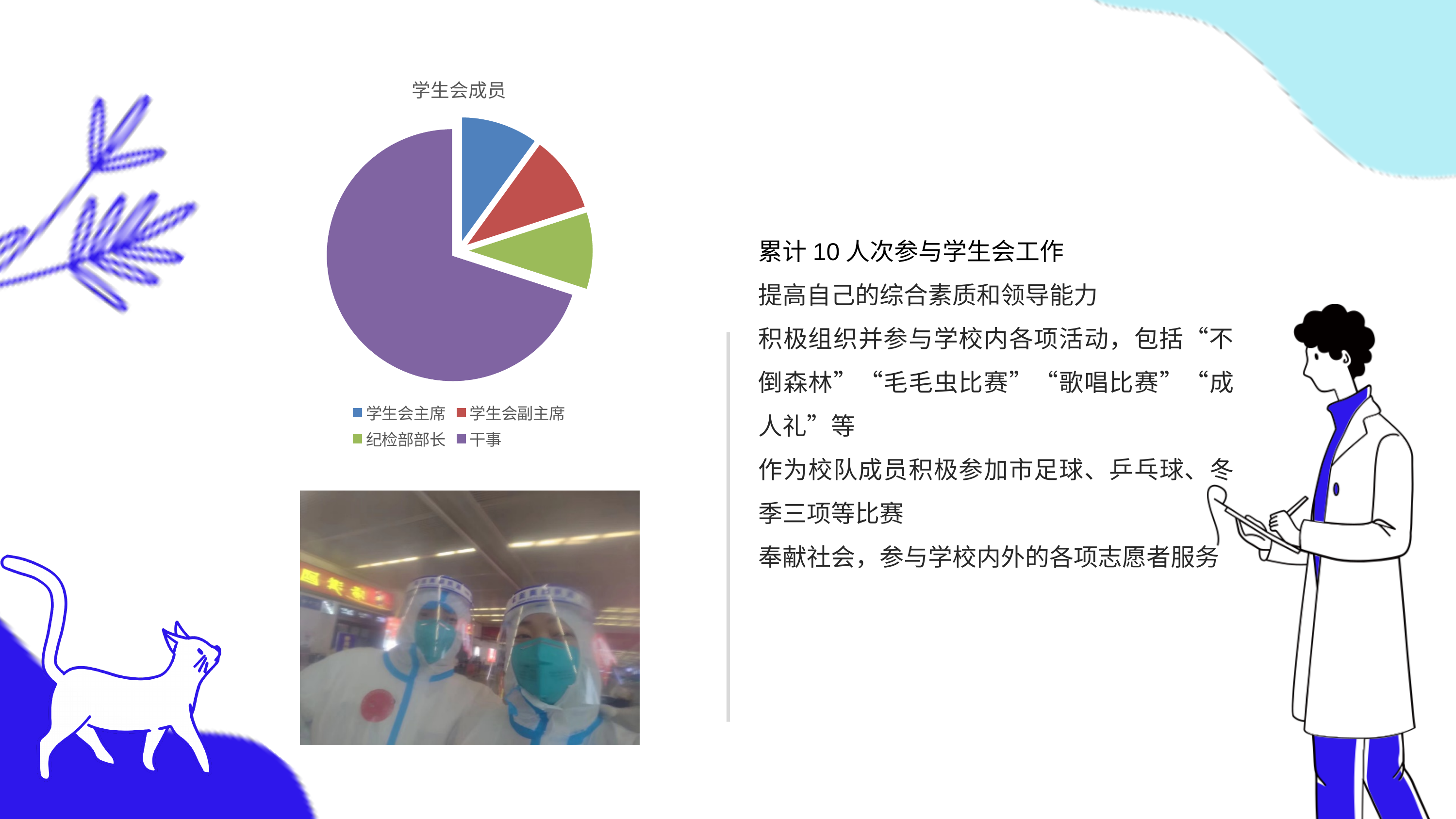
Which category has the largest slice in the pie chart? 干事 How many categories does the pie chart show? 4 What kind of chart is shown on the slide? pie chart Which is larger in the pie chart, the slice for 干事 or the slice for 学生会主席? 干事 What is the title of the pie chart? 学生会成员 Which colour represents 干事 in the pie chart? purple Which is larger in the pie chart, the slice for 干事 or the slice for 纪检部部长? 干事 Does the slice for 干事 take up more or less than half of the pie chart? more